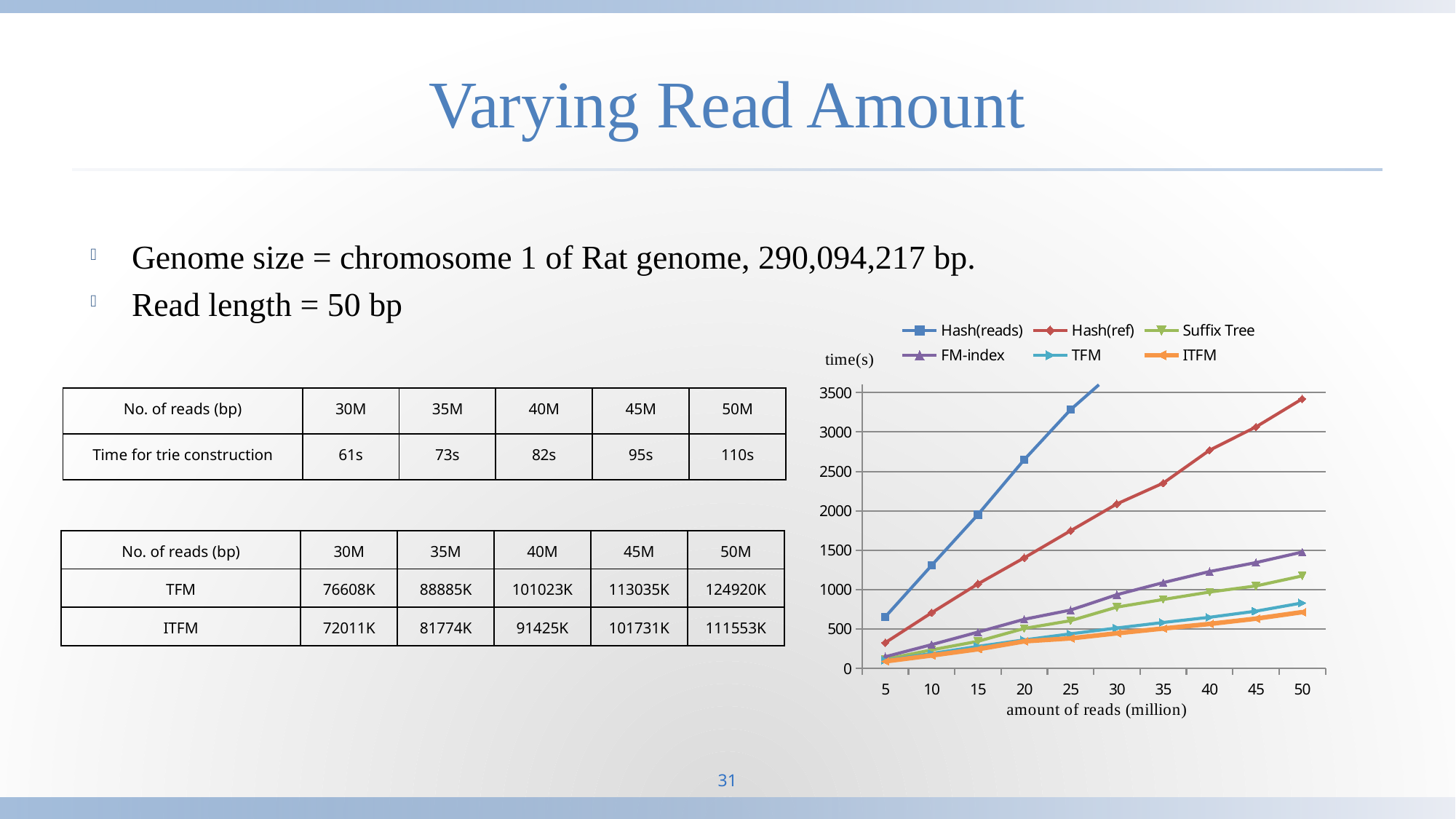
Which series has the lowest time at 50 million reads? ITFM Is the time for TFM at 50 million reads greater or less than 1000? less How many series does the chart's legend list? 6 Does the time for Hash(ref) rise or fall as the amount of reads increases? rise How many tick values are shown on the x axis (amount of reads) of the chart? 10 Is the time for Hash(ref) at 50 million reads greater or less than 3000? greater Is the time for Suffix Tree at 50 million reads greater or less than 1000? greater At 20 million reads, which is larger: the time for Hash(reads) or Hash(ref)? Hash(reads) What kind of chart is shown on the slide? line chart What is the label of the x axis of the chart? amount of reads (million)